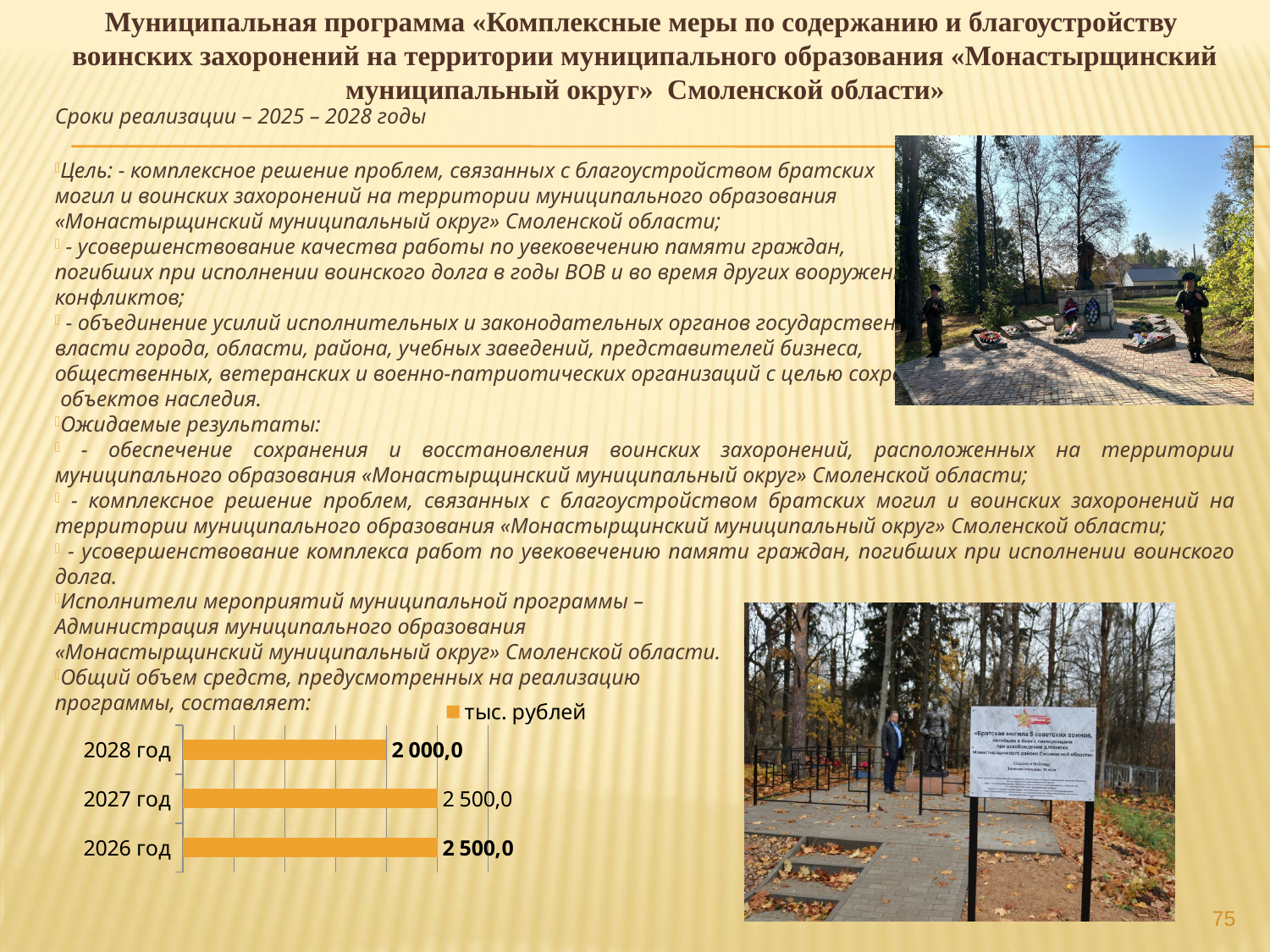
Which year has the lowest value? 2028 год What is the value for 2027 год? 2 500,0 How many years are shown in the chart? 3 How many series does the legend list? 1 What is the difference between the values for 2027 год and 2028 год? 500,0 Which is larger, the value for 2027 год or for 2028 год? 2027 год What is the value for 2028 год? 2 000,0 Are the values for 2026 год and 2027 год equal? yes What kind of chart is shown on the slide? bar chart What is the value for 2026 год? 2 500,0 What is the legend entry of the chart? тыс. рублей